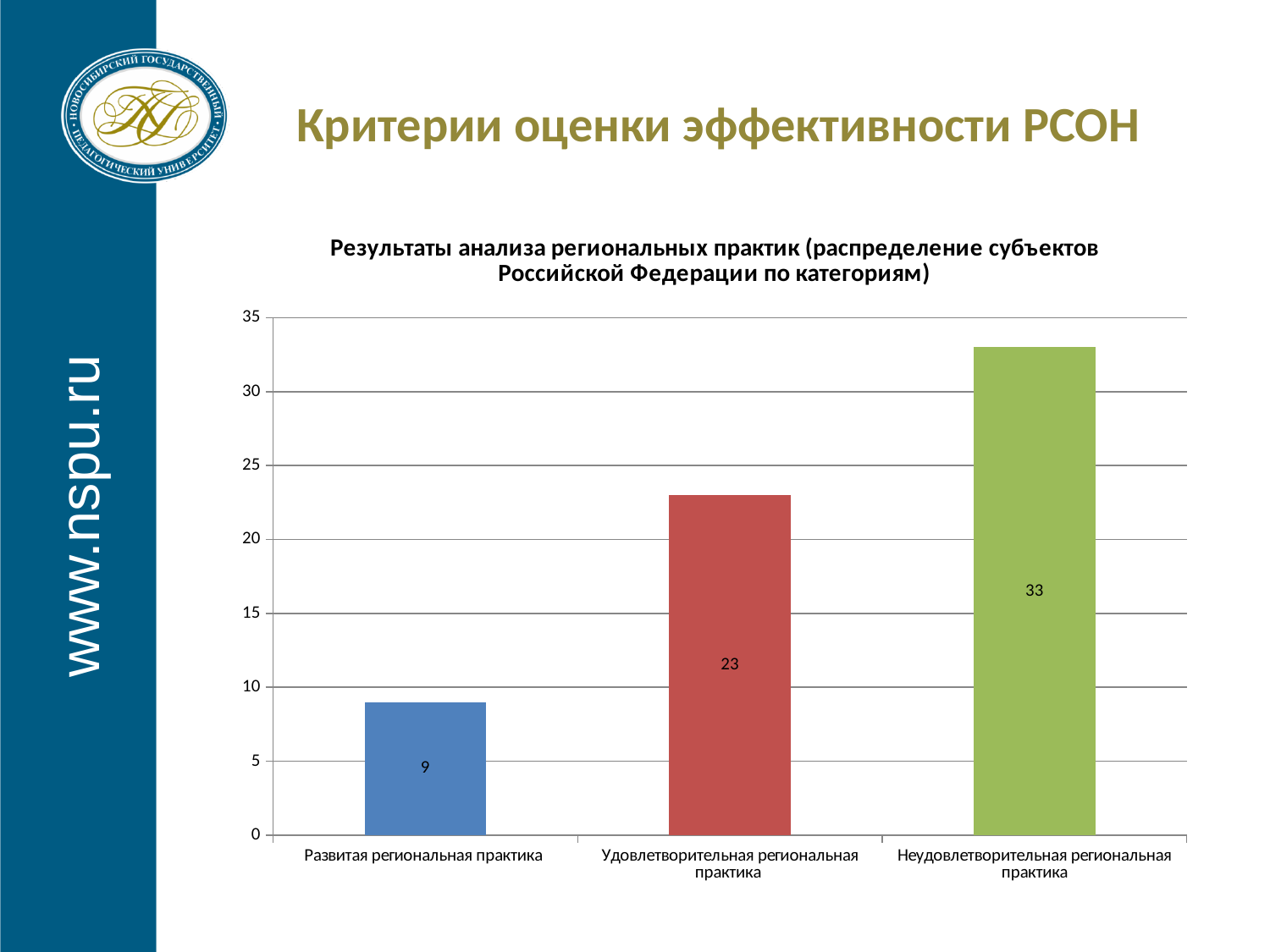
Which category has the lowest value? Развитая региональная практика What is the value for Развитая региональная практика? 9 What is the difference between the values for Неудовлетворительная региональная практика and Удовлетворительная региональная практика? 10 What is the value for Удовлетворительная региональная практика? 23 What is the value for Неудовлетворительная региональная практика? 33 How many categories are shown on the chart? 3 Is the value for Неудовлетворительная региональная практика greater or less than 30? greater Do the values rise or fall from left to right across the categories? rise Which is larger: the value for Развитая региональная практика or the value for Удовлетворительная региональная практика? Удовлетворительная региональная практика What kind of chart is shown on the slide? bar chart Which category has the highest value? Неудовлетворительная региональная практика What is the difference between the values for Удовлетворительная региональная практика and Развитая региональная практика? 14